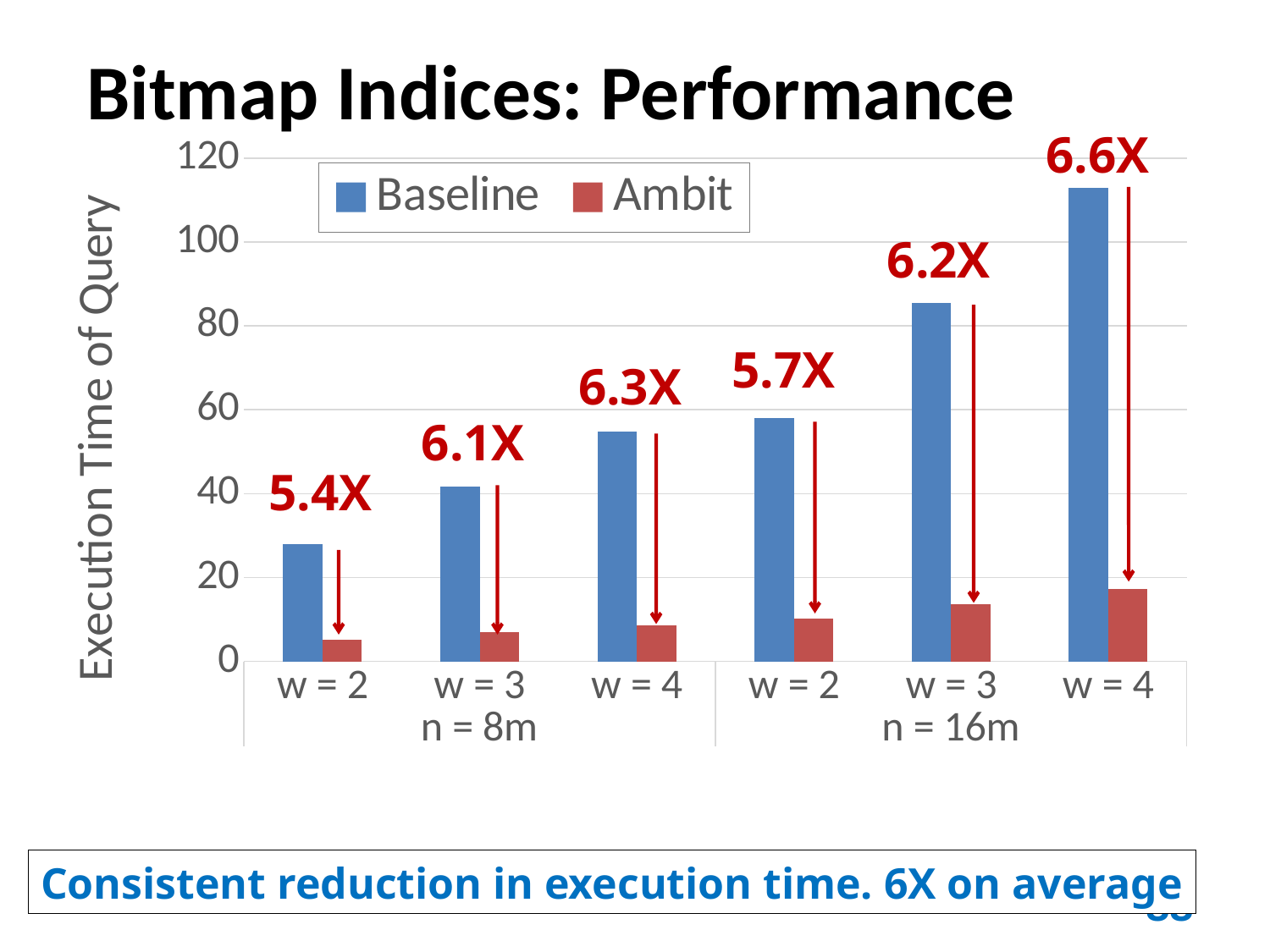
Which category has the highest Baseline execution time? w = 4, n = 16m What speedup is labelled above the bars for w = 2 with n = 8m? 5.4X Which category has the lowest Baseline execution time? w = 2, n = 8m Is the Ambit value for w = 2 with n = 16m greater or less than 20? less Which is larger for w = 3 with n = 8m, the Baseline bar or the Ambit bar? Baseline What are the two series named in the legend? Baseline and Ambit Is the Baseline value for w = 4 with n = 16m greater or less than 100? greater What kind of chart is shown on the slide? bar chart What speedup is labelled above the bars for w = 3 with n = 16m? 6.2X What speedup is labelled above the bars for w = 4 with n = 16m? 6.6X How many series does the legend list? 2 How many categories are shown along the x axis? 6